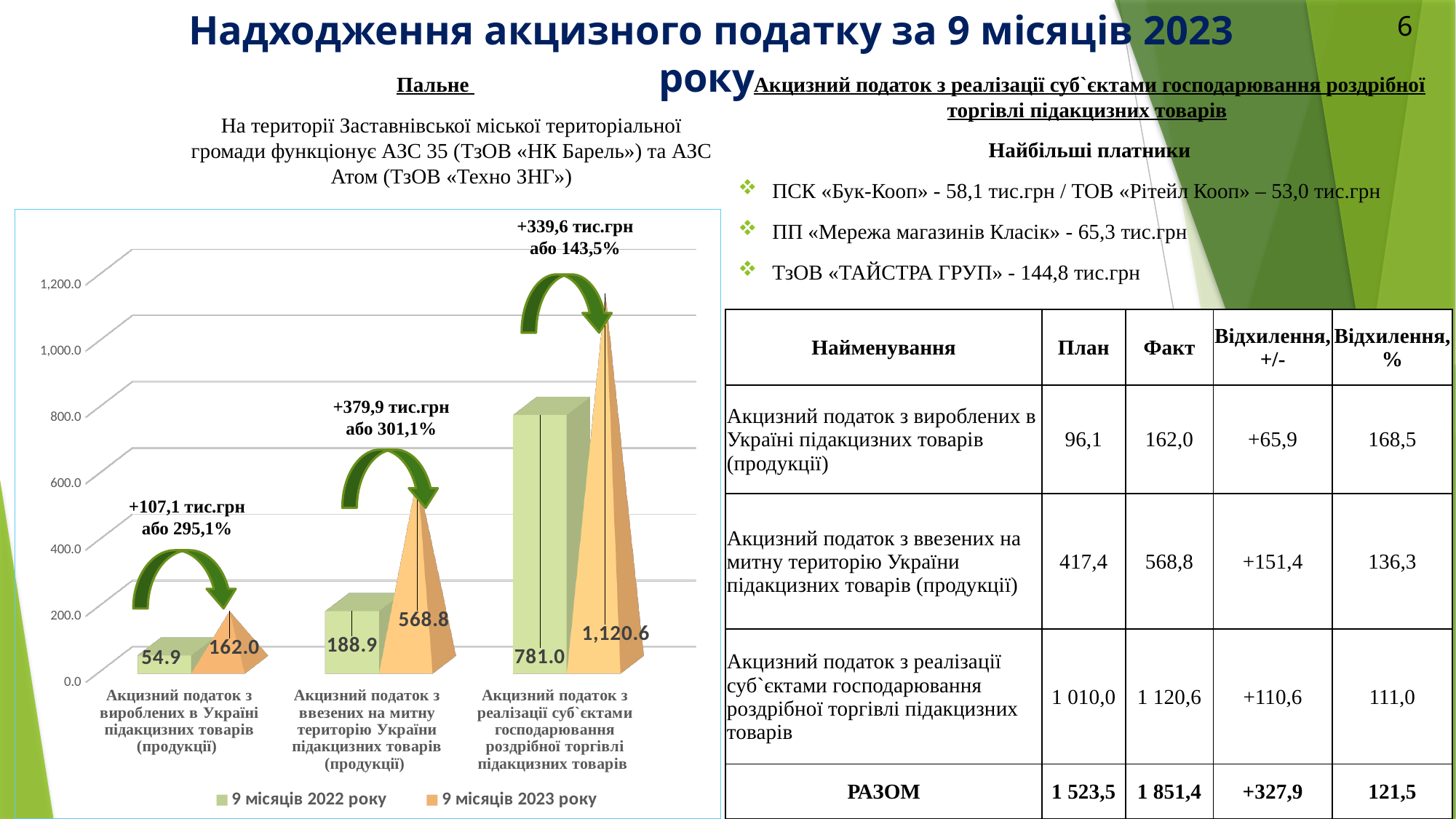
How many categories are shown on the x axis of the chart? 3 How many series does the chart legend list? 2 Which category has the lowest value for '9 місяців 2023 року'? Акцизний податок з вироблених в Україні підакцизних товарів (продукції) What kind of chart is shown on the slide? bar chart What is the value for '9 місяців 2023 року' in the category 'Акцизний податок з реалізації суб`єктами господарювання роздрібної торгівлі підакцизних товарів'? 1,120.6 What is the value for '9 місяців 2023 року' in the category 'Акцизний податок з ввезених на митну територію України підакцизних товарів (продукції)'? 568.8 Is the '9 місяців 2023 року' value for 'Акцизний податок з реалізації суб`єктами господарювання роздрібної торгівлі підакцизних товарів' greater or less than 1,000.0? greater What percentage increase is annotated above the category 'Акцизний податок з ввезених на митну територію України підакцизних товарів (продукції)'? 301,1% Which is larger: the '9 місяців 2022 року' value for 'Акцизний податок з реалізації суб`єктами господарювання роздрібної торгівлі підакцизних товарів' or the '9 місяців 2023 року' value for 'Акцизний податок з ввезених на митну територію України підакцизних товарів (продукції)'? 9 місяців 2022 року value for Акцизний податок з реалізації суб`єктами господарювання роздрібної торгівлі підакцизних товарів (781.0) What is the value for '9 місяців 2022 року' in the category 'Акцизний податок з вироблених в Україні підакцизних товарів (продукції)'? 54.9 What is the difference between the '9 місяців 2023 року' and '9 місяців 2022 року' values for 'Акцизний податок з вироблених в Україні підакцизних товарів (продукції)'? 107.1 Which category has the highest value for '9 місяців 2022 року'? Акцизний податок з реалізації суб`єктами господарювання роздрібної торгівлі підакцизних товарів